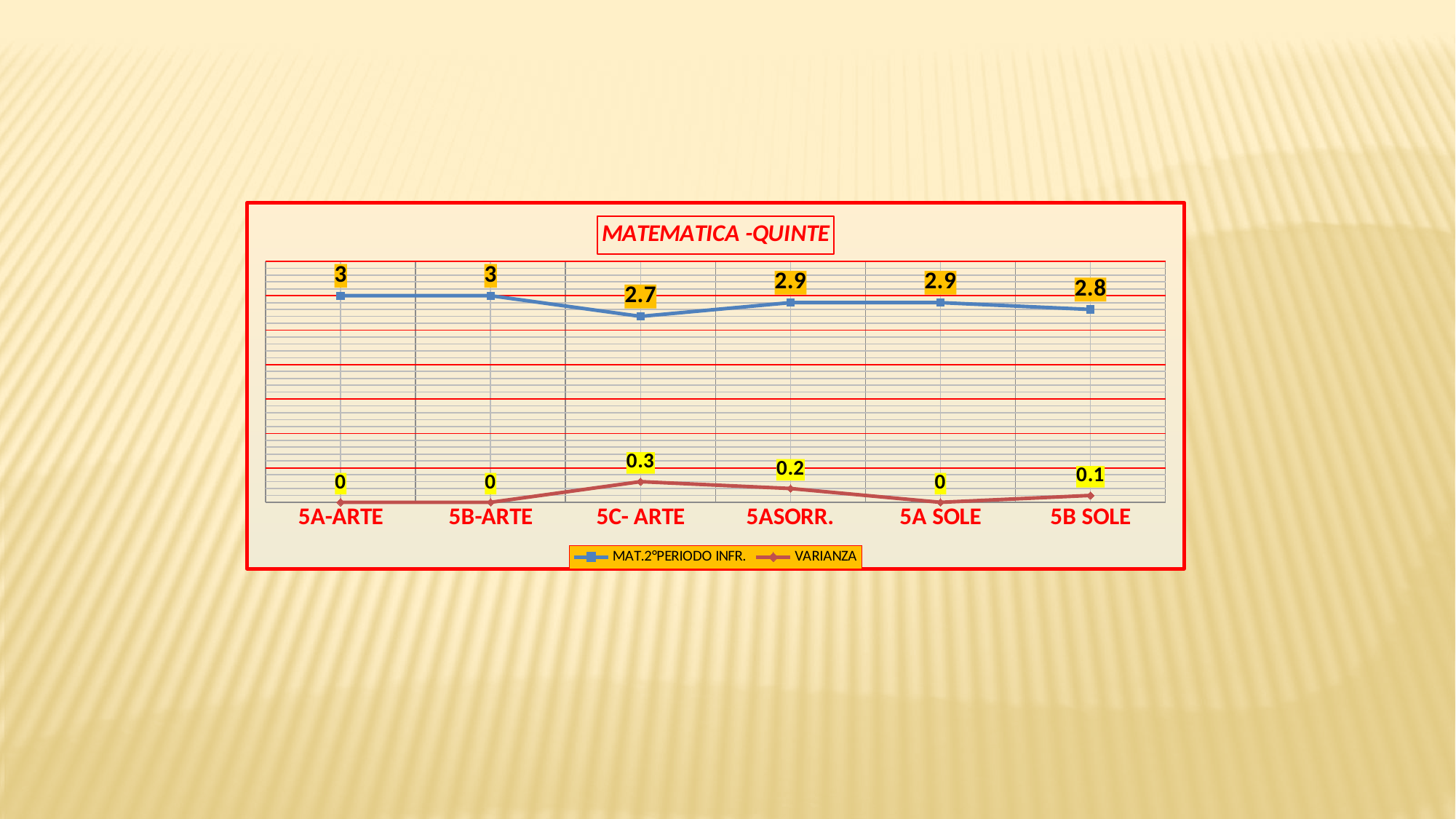
What kind of chart is shown? line chart What is the MAT.2°PERIODO INFR. value for 5C- ARTE? 2.7 What is the title of the chart? MATEMATICA -QUINTE What is the VARIANZA value for 5ASORR.? 0.2 What is the MAT.2°PERIODO INFR. value for 5B SOLE? 2.8 What is the difference between the MAT.2°PERIODO INFR. values for 5A-ARTE and 5C- ARTE? 0.3 What is the VARIANZA value for 5B SOLE? 0.1 How many series does the legend list? 2 Which category has the highest VARIANZA value? 5C- ARTE Which is larger, the MAT.2°PERIODO INFR. value for 5ASORR. or for 5B SOLE? 5ASORR. Which category has the lowest MAT.2°PERIODO INFR. value? 5C- ARTE How many categories are shown on the x axis? 6